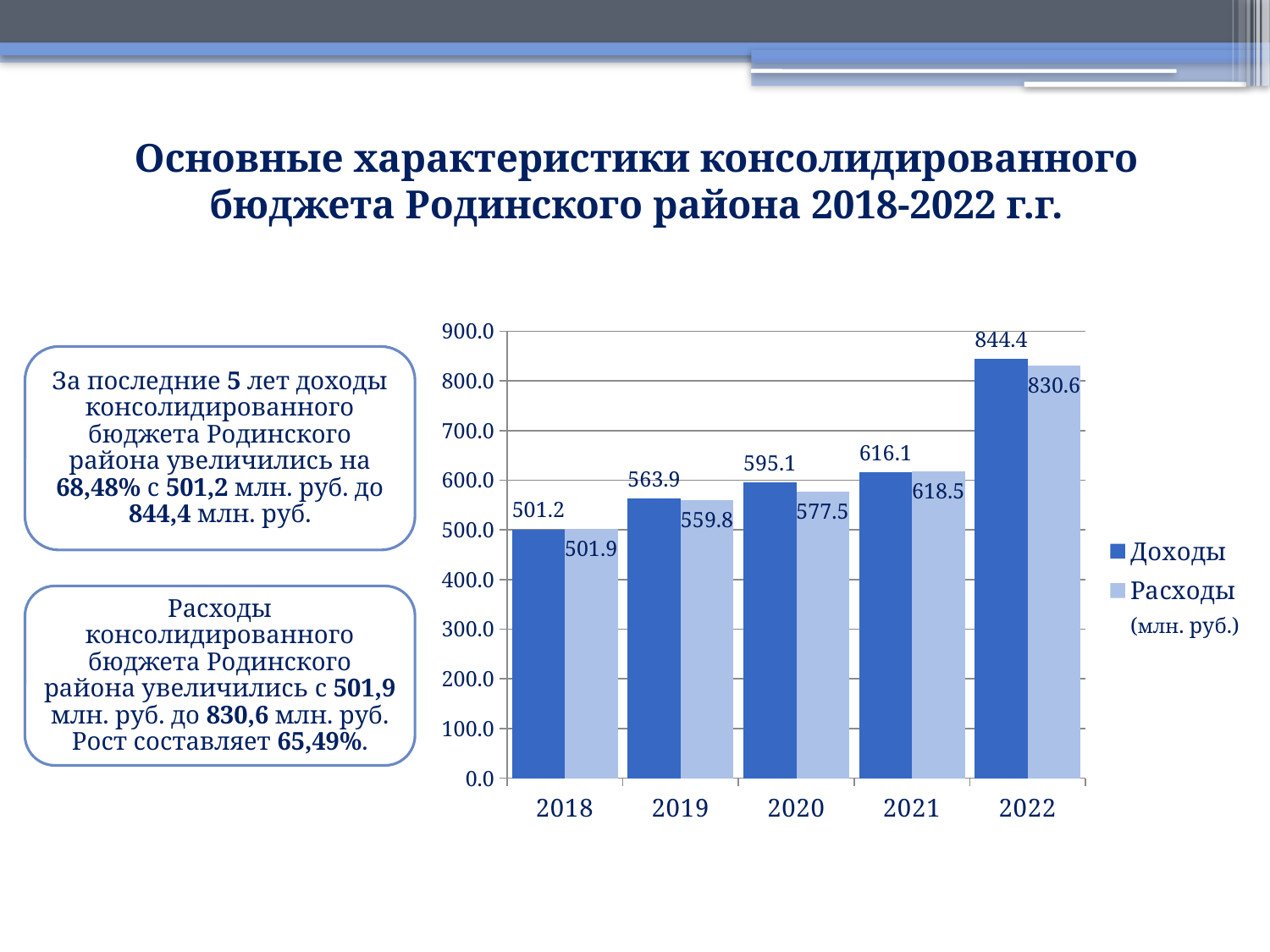
Which year has the lowest Расходы value? 2018 Which year has the highest Доходы value? 2022 What is the value of Доходы for 2020? 595.1 How many series does the legend list? 2 How many years are shown on the x axis? 5 Is the value of Расходы for 2022 greater or less than 800.0? greater What is the difference between Доходы and Расходы in 2022? 13.8 What kind of chart is shown on the slide? bar chart What is the value of Расходы for 2021? 618.5 Which is larger in 2018, Доходы or Расходы? Расходы Do the Доходы values rise or fall from 2018 to 2022? rise What unit is given below the legend? млн. руб.